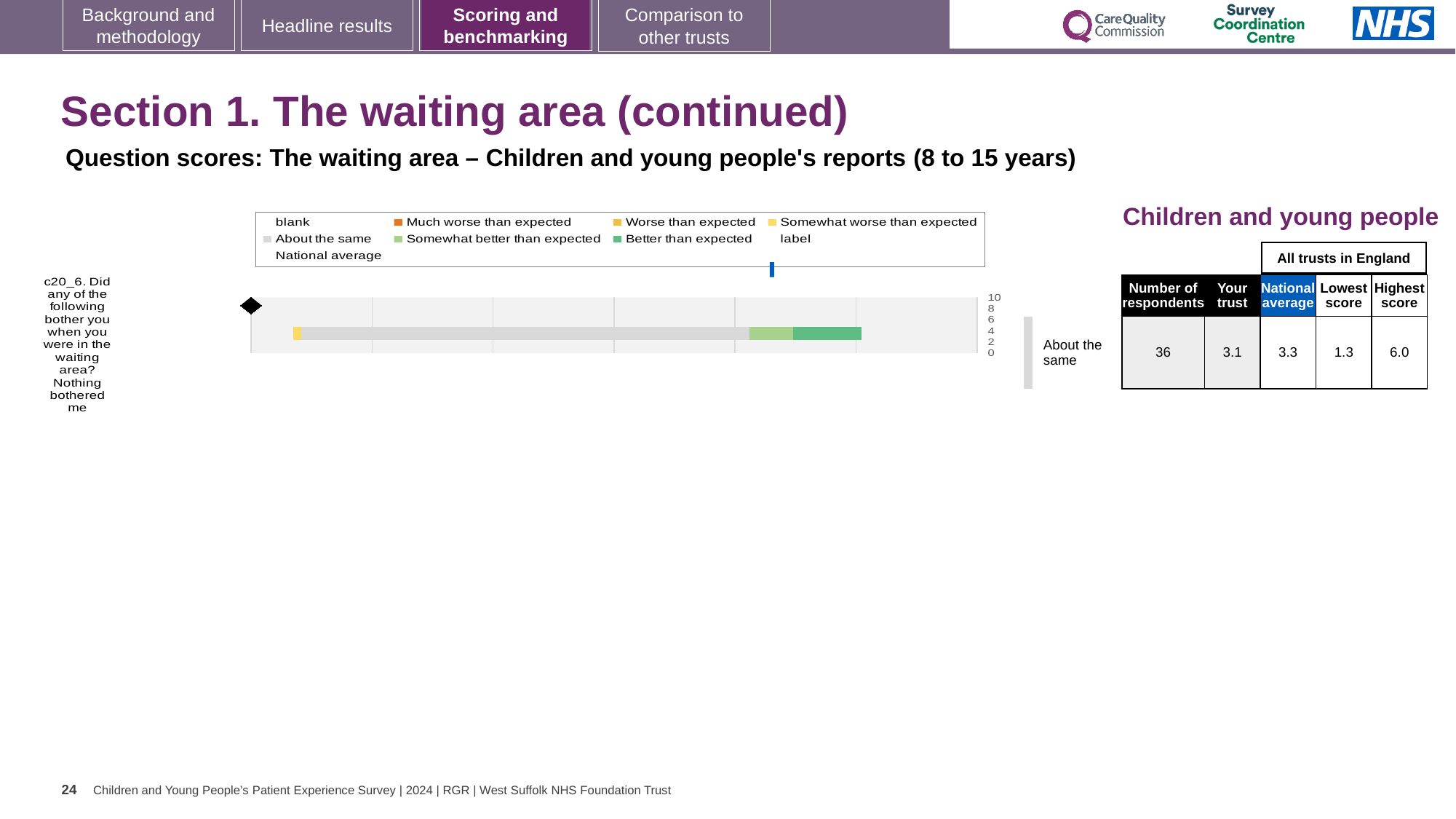
How many respondents answered question c20_6? 36 How many questions (categories) are plotted in the chart? 1 What is the lowest score among all trusts in England for question c20_6? 1.3 What benchmark category label is shown to the right of the bar for question c20_6? About the same Which is larger for question c20_6, the 'Your trust' score or the national average? national average What is the difference between the highest score (6.0) and the lowest score (1.3) for question c20_6? 4.7 What is the difference between the national average (3.3) and the 'Your trust' score (3.1) for question c20_6? 0.2 What is the 'Your trust' score for question c20_6 shown in the table beside the chart? 3.1 What is the national average score for question c20_6 shown in the table beside the chart? 3.3 What kind of chart is shown on the slide? bar chart What is the highest value shown on the chart's numeric axis? 10 What is the highest score among all trusts in England for question c20_6? 6.0